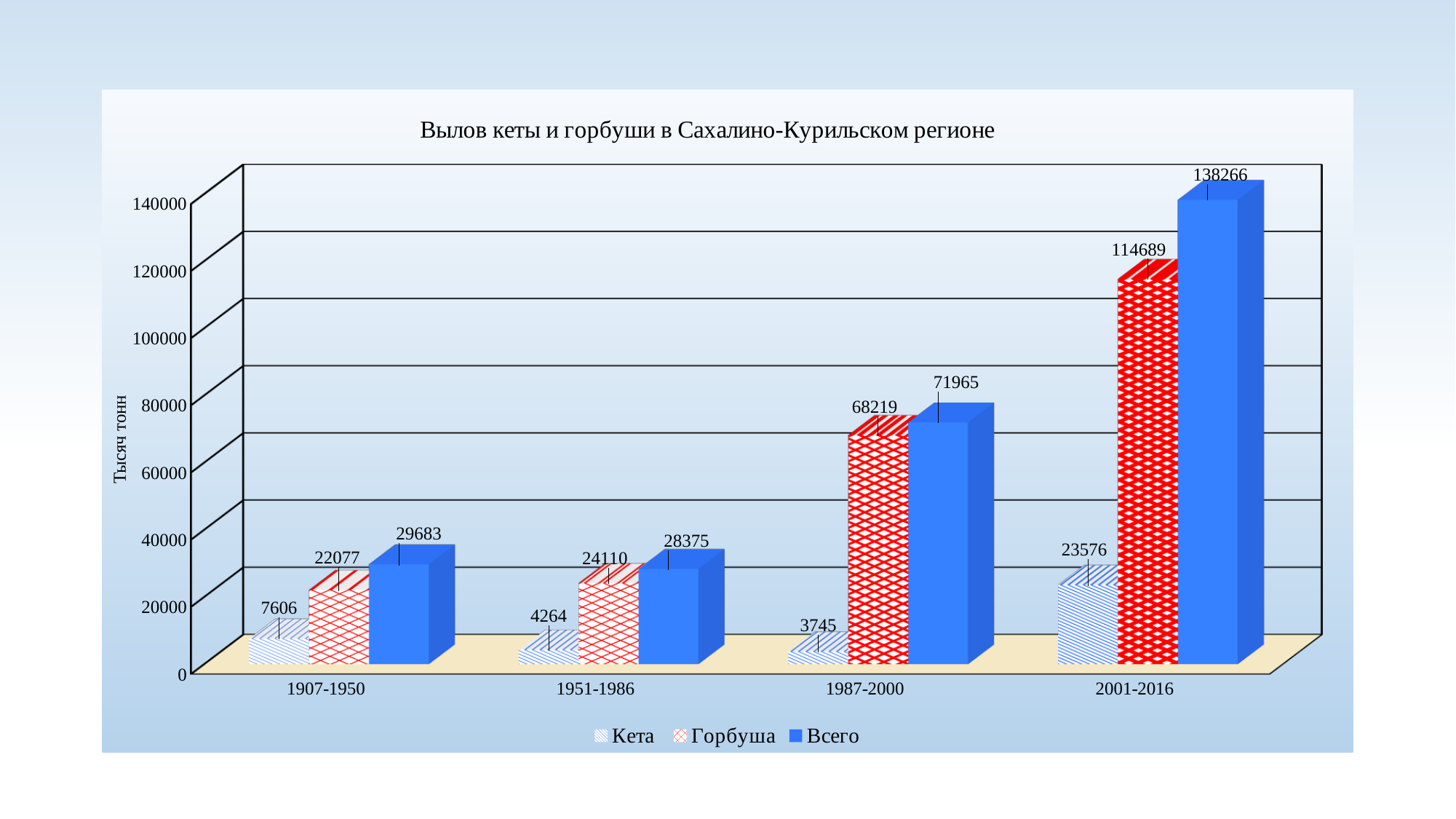
What is the value for Всего in 1987-2000? 71965 Which is larger: Горбуша in 1951-1986 or Горбуша in 1907-1950? Горбуша in 1951-1986 What is the value for Горбуша in 2001-2016? 114689 How many series does the legend list? 3 What is the value for Кета in 1907-1950? 7606 Is the value for Всего in 1987-2000 greater or less than 60000? greater How many periods are shown on the x axis? 4 Which period has the lowest value for Кета? 1987-2000 What is the title of the chart? Вылов кеты и горбуши в Сахалино-Курильском регионе What kind of chart is shown? bar chart Which period has the highest value for Всего? 2001-2016 What is the difference between Всего and Горбуша in 2001-2016? 23577